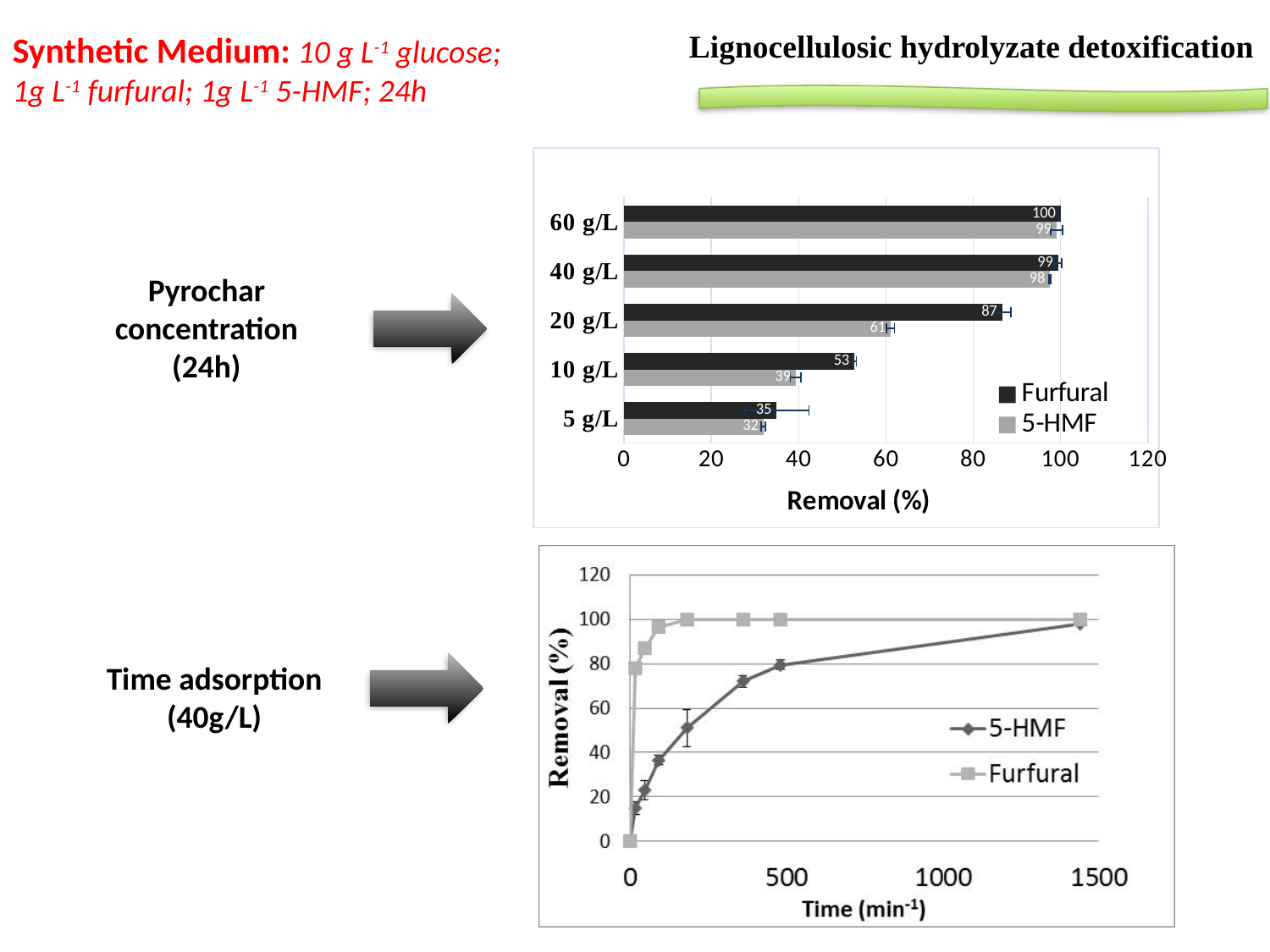
In the top bar chart (Pyrochar concentration), how many concentration categories are shown? 5 In the top bar chart (Pyrochar concentration), which concentration has the lowest 5-HMF removal? 5 g/L In the bottom line chart (Time adsorption), is the 5-HMF removal at 100 min greater or less than 60? less In the top bar chart (Pyrochar concentration), at 10 g/L, which is larger: Furfural removal or 5-HMF removal? Furfural In the top bar chart (Pyrochar concentration), which concentration has the highest Furfural removal? 60 g/L In the bottom line chart (Time adsorption), what is the label of the x axis? Time (min-1) What kind of chart is the top chart (Pyrochar concentration)? Bar chart In the top bar chart (Pyrochar concentration), what is the 5-HMF removal at 10 g/L? 39 In the top bar chart (Pyrochar concentration), what is the Furfural removal at 20 g/L? 87 In the top bar chart (Pyrochar concentration), what is the difference between Furfural and 5-HMF removal at 20 g/L? 26 What kind of chart is the bottom chart (Time adsorption)? Line chart In the top bar chart (Pyrochar concentration), how many series does the legend list? 2